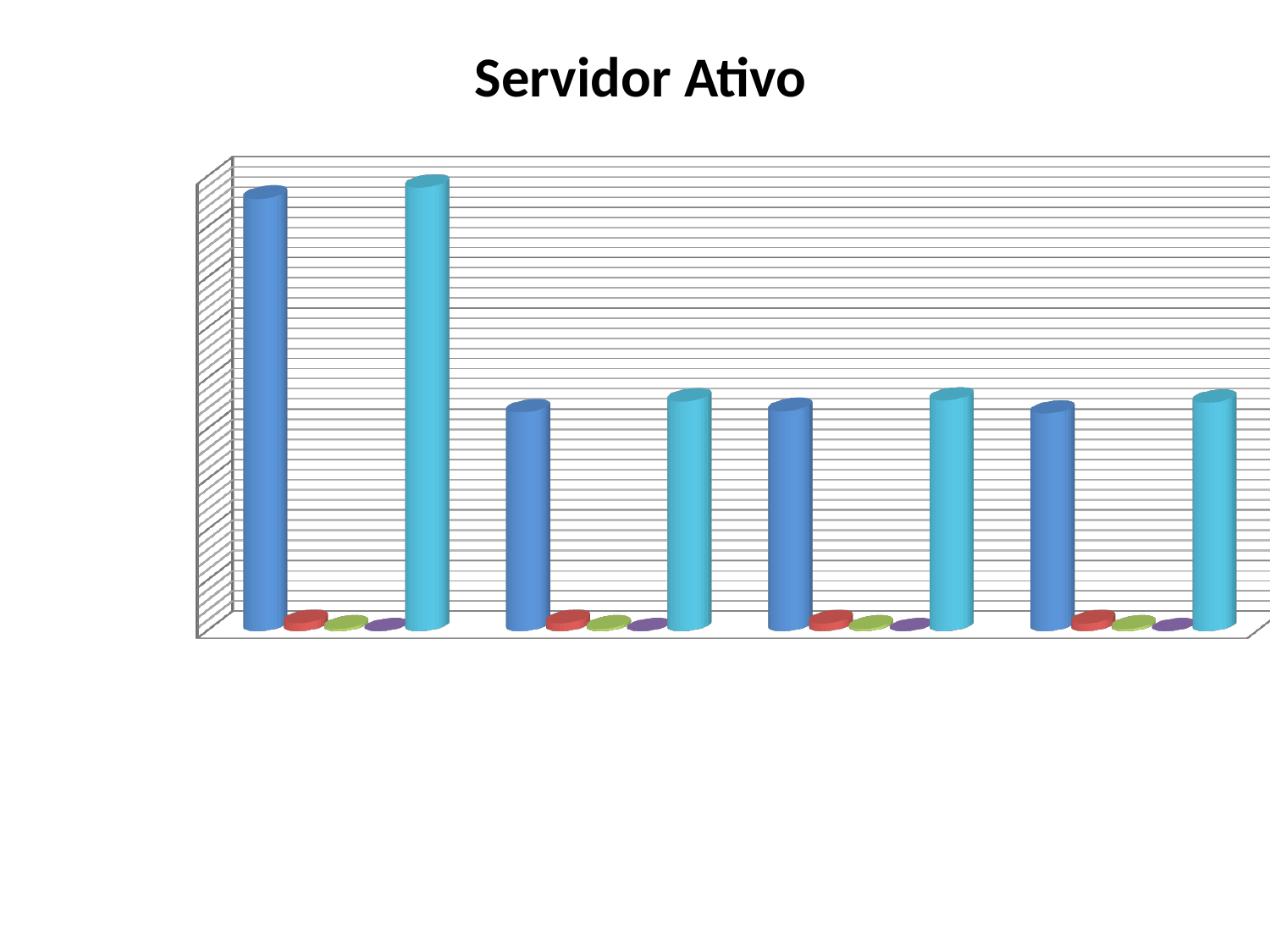
How many bars are there in each group? 5 How many groups of bars are plotted along the x axis? 4 Which is taller: the cyan bar in the leftmost group or the cyan bar in the rightmost group? the cyan bar in the leftmost group Within each group, which colour of bar is the shortest: blue, cyan or purple? purple How many different bar colours are used in the chart? 5 Within the leftmost group, which is taller: the blue bar or the red bar? the blue bar Which group of bars, counting from the left, contains the tallest bars? the first (leftmost) group What is the title of the chart? Servidor Ativo What kind of chart is shown on the slide? bar chart Which is taller: the blue bar in the leftmost group or the blue bar in the second group from the left? the blue bar in the leftmost group